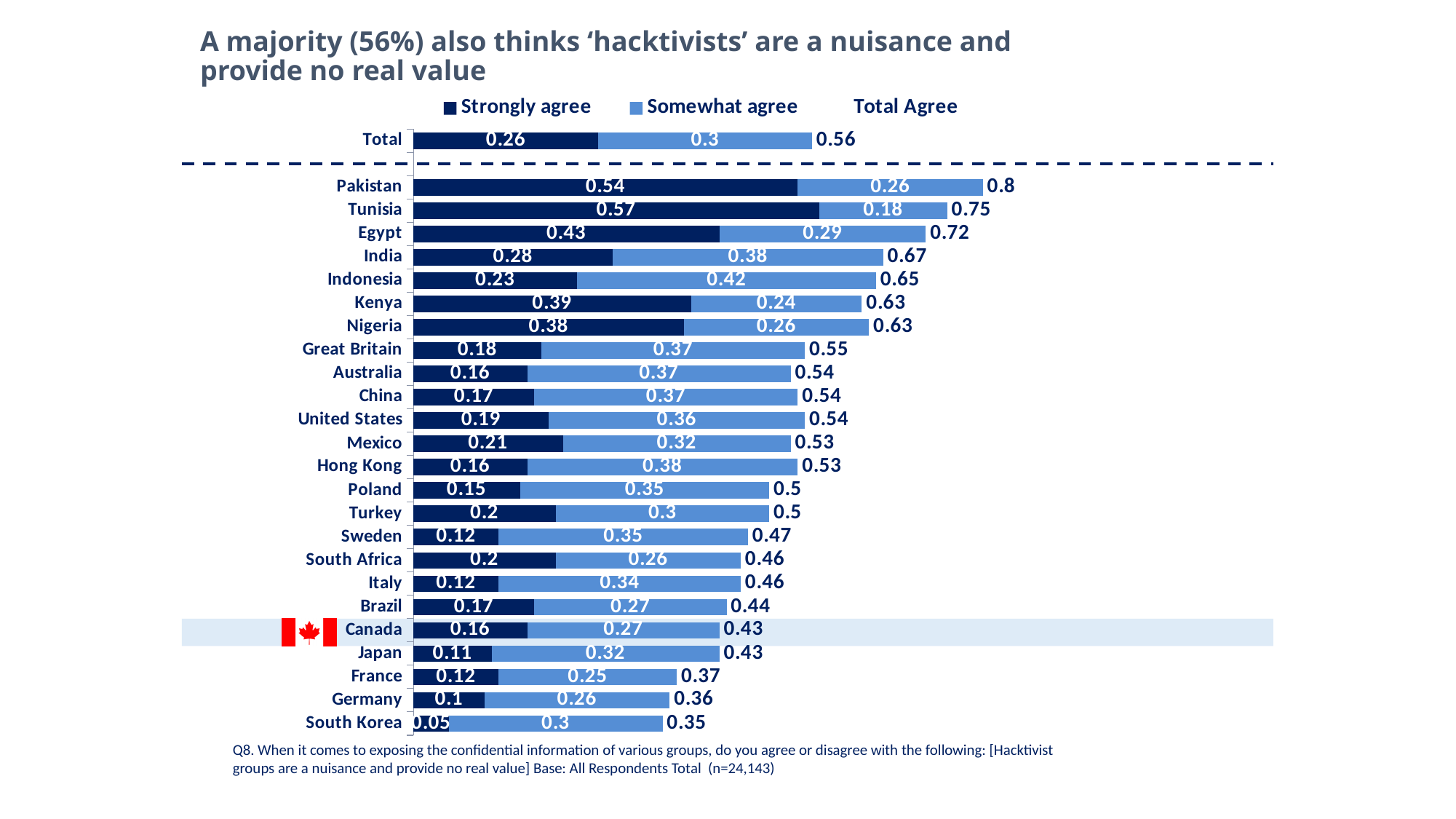
What is the difference between the Total Agree values for Pakistan and Tunisia? 0.05 Which country has the highest Strongly agree value? Tunisia How many entries does the legend list? 3 What kind of chart is shown on the slide? Stacked bar chart Which country has the lowest Total Agree value? South Korea What is the Somewhat agree value for Indonesia? 0.42 What is the total of the stacked bar for Total? 0.56 What is the Total Agree value for Canada? 0.43 Which country has the highest Total Agree value? Pakistan Which has a larger Strongly agree value, Egypt or India? Egypt How many countries are shown in the chart, excluding the Total bar? 24 What is the Strongly agree value for Pakistan? 0.54